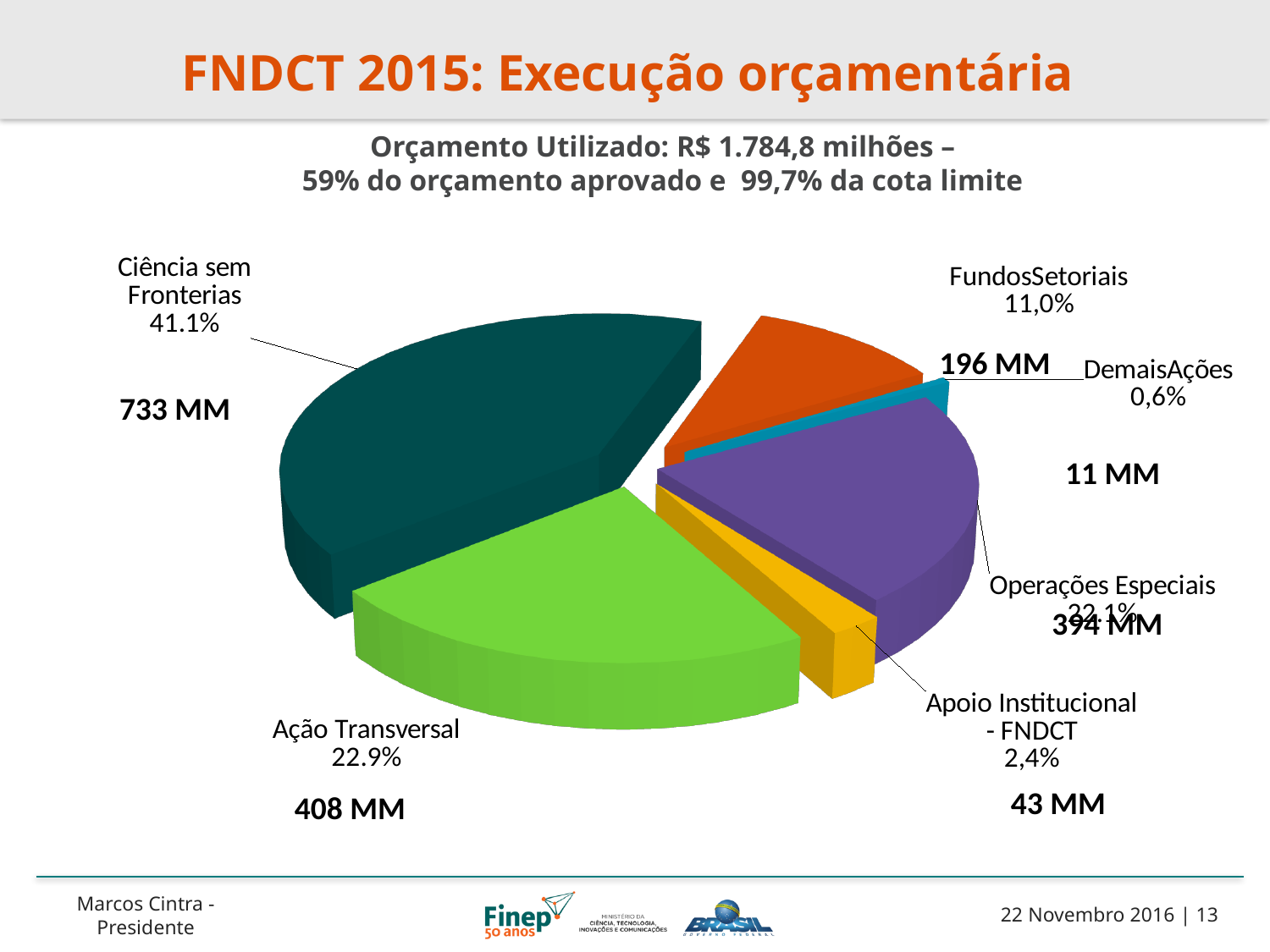
Which category has the smallest slice of the pie? DemaisAções What is the value shown for Ação Transversal? 408 MM Which category has the largest slice of the pie? Ciência sem Fronteiras What is the value shown for DemaisAções? 11 MM What kind of chart is shown on the slide? pie chart What percentage is shown for DemaisAções? 0,6% What is the difference between the value for Ciência sem Fronteiras and the value for Ação Transversal? 325 MM What share of the pie does Ciência sem Fronteiras represent? 41.1% Which is larger, the value for Ação Transversal or the value for FundosSetoriais? Ação Transversal How many slices does the pie chart have? 6 What percentage is shown for FundosSetoriais? 11,0% What is the value shown for Apoio Institucional - FNDCT? 43 MM